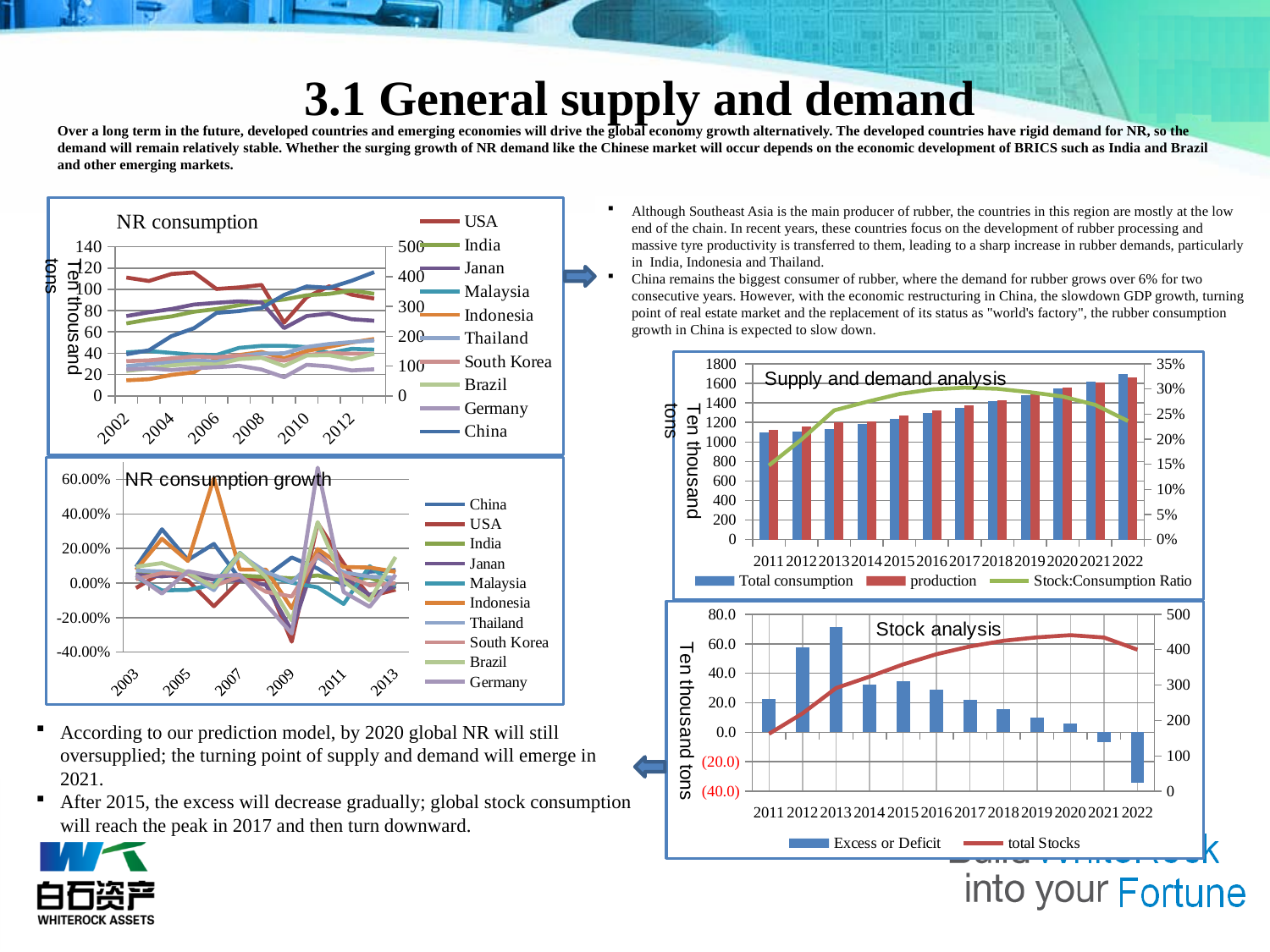
In the "Supply and demand analysis" chart, does Total consumption rise or fall from 2011 to 2022? rise In the "Supply and demand analysis" chart, which series is plotted as a line rather than bars? Stock:Consumption Ratio What kind of chart is the "NR consumption" chart? line chart In the "Stock analysis" chart, which year has the highest Excess or Deficit bar? 2013 How many series does the legend of the "Stock analysis" chart list? 2 How many series does the legend of the "Supply and demand analysis" chart list? 3 How many years are shown on the x axis of the "Stock analysis" chart? 12 In the "Supply and demand analysis" chart, is the Total consumption value for 2022 greater or less than 1600? greater In the "Supply and demand analysis" chart, is the Total consumption value for 2011 greater or less than 1200? less How many series does the legend of the "NR consumption growth" chart list? 10 In the "Stock analysis" chart, is the Excess or Deficit value for 2013 greater or less than 60.0? greater